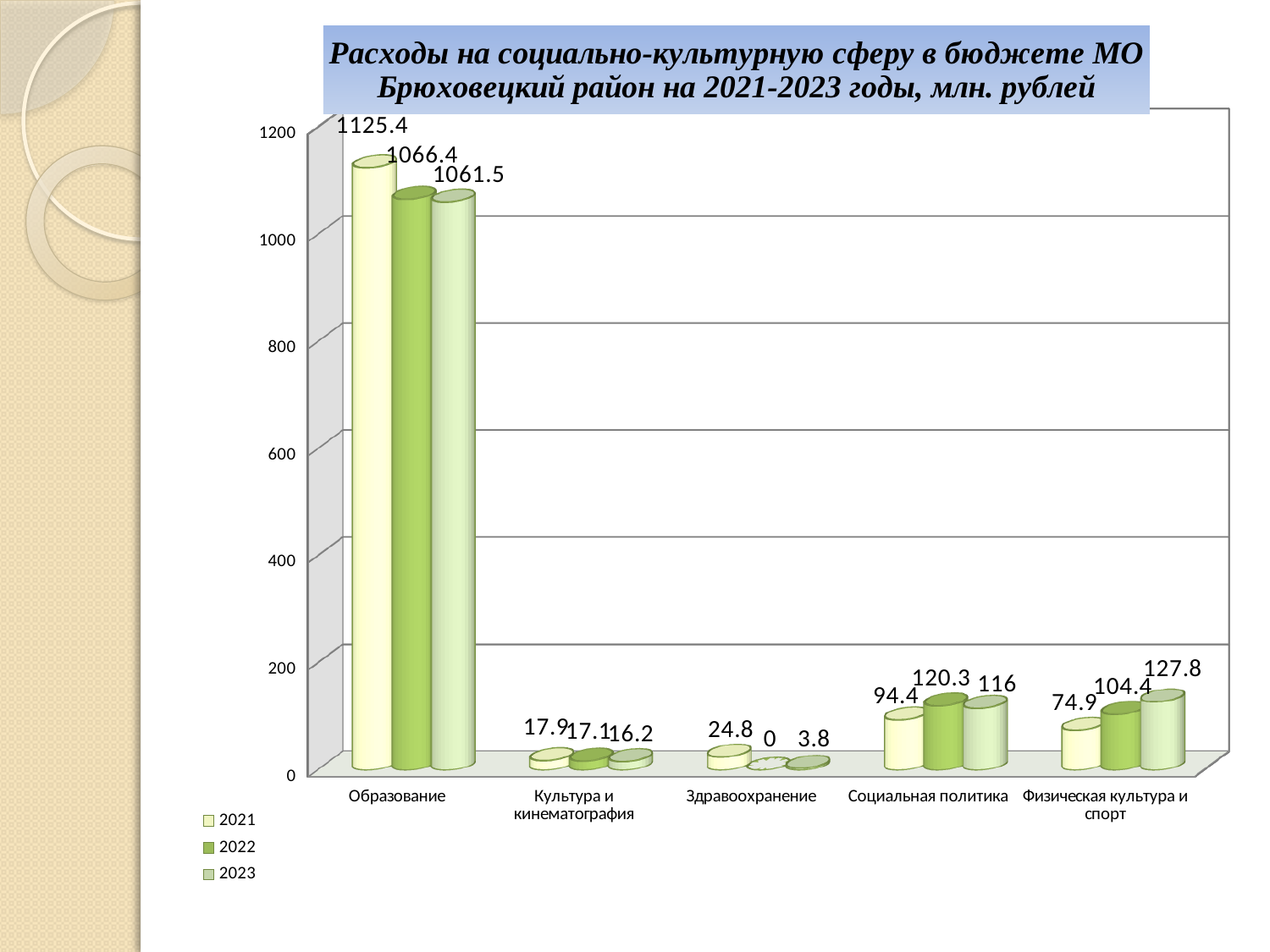
What kind of chart is shown on the slide? Bar chart What is the value for Здравоохранение in 2022? 0 How many categories are shown on the x axis? 5 What is the value for Социальная политика in 2022? 120.3 Which category has the lowest value in 2022? Здравоохранение How many series does the legend list? 3 Which is larger: the 2022 value for Социальная политика or the 2022 value for Физическая культура и спорт? Социальная политика Do the values for Физическая культура и спорт rise or fall from 2021 to 2023? Rise Which category has the highest value in 2023? Образование What is the value for Образование in 2021? 1125.4 What is the value for Физическая культура и спорт in 2023? 127.8 What is the difference between the 2021 and 2023 values for Образование? 63.9